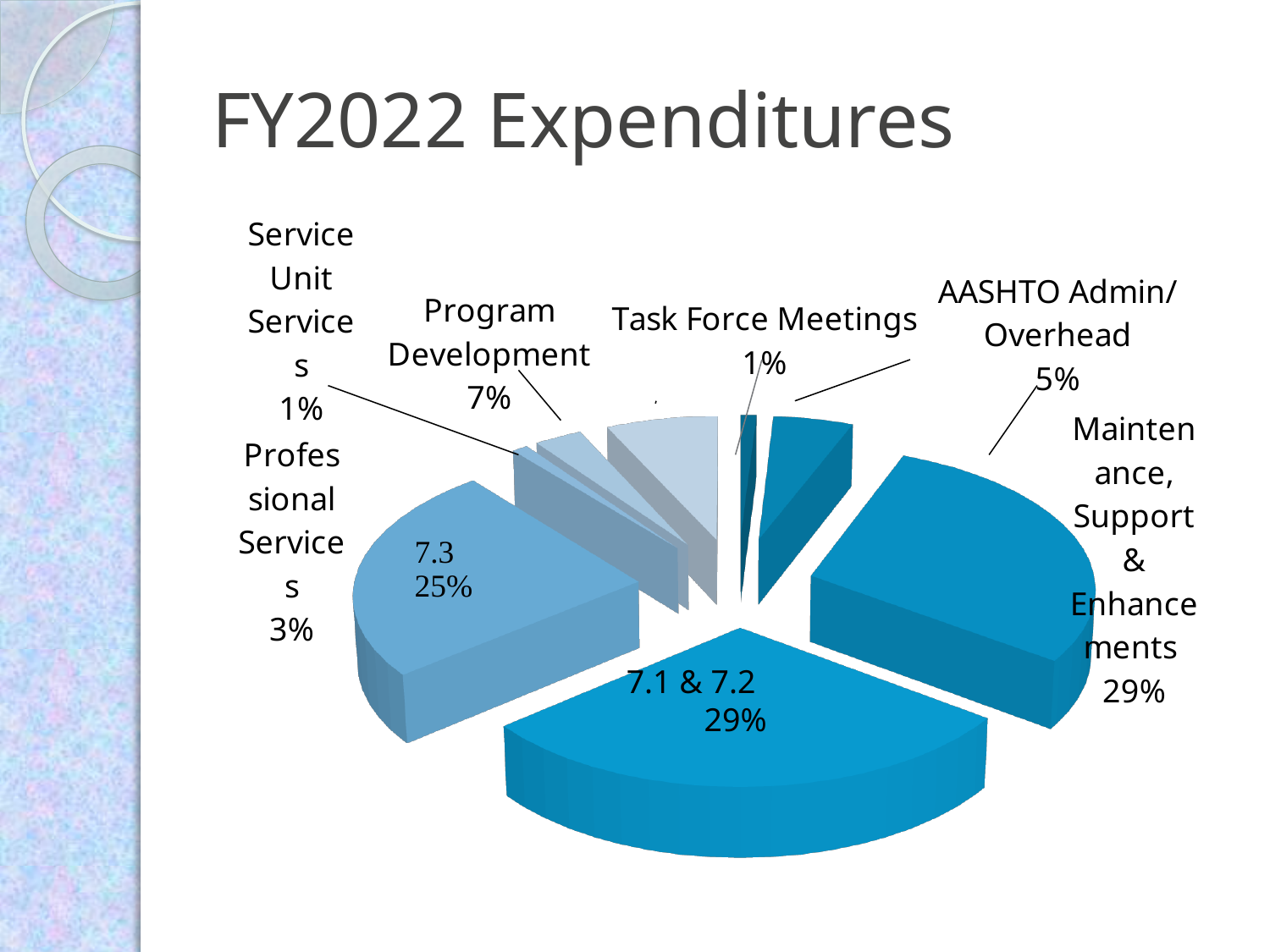
What share of FY2022 expenditures is 7.1 & 7.2? 29% Which is larger, the share for 7.3 or the share for Program Development? 7.3 What is the title of the chart? FY2022 Expenditures How many slices does the pie chart have? 8 What kind of chart is shown on the slide? pie chart What share of FY2022 expenditures is Task Force Meetings? 1% What is the difference in percentage points between the share for 7.1 & 7.2 and the share for 7.3? 4 What share of FY2022 expenditures is Professional Services? 3%